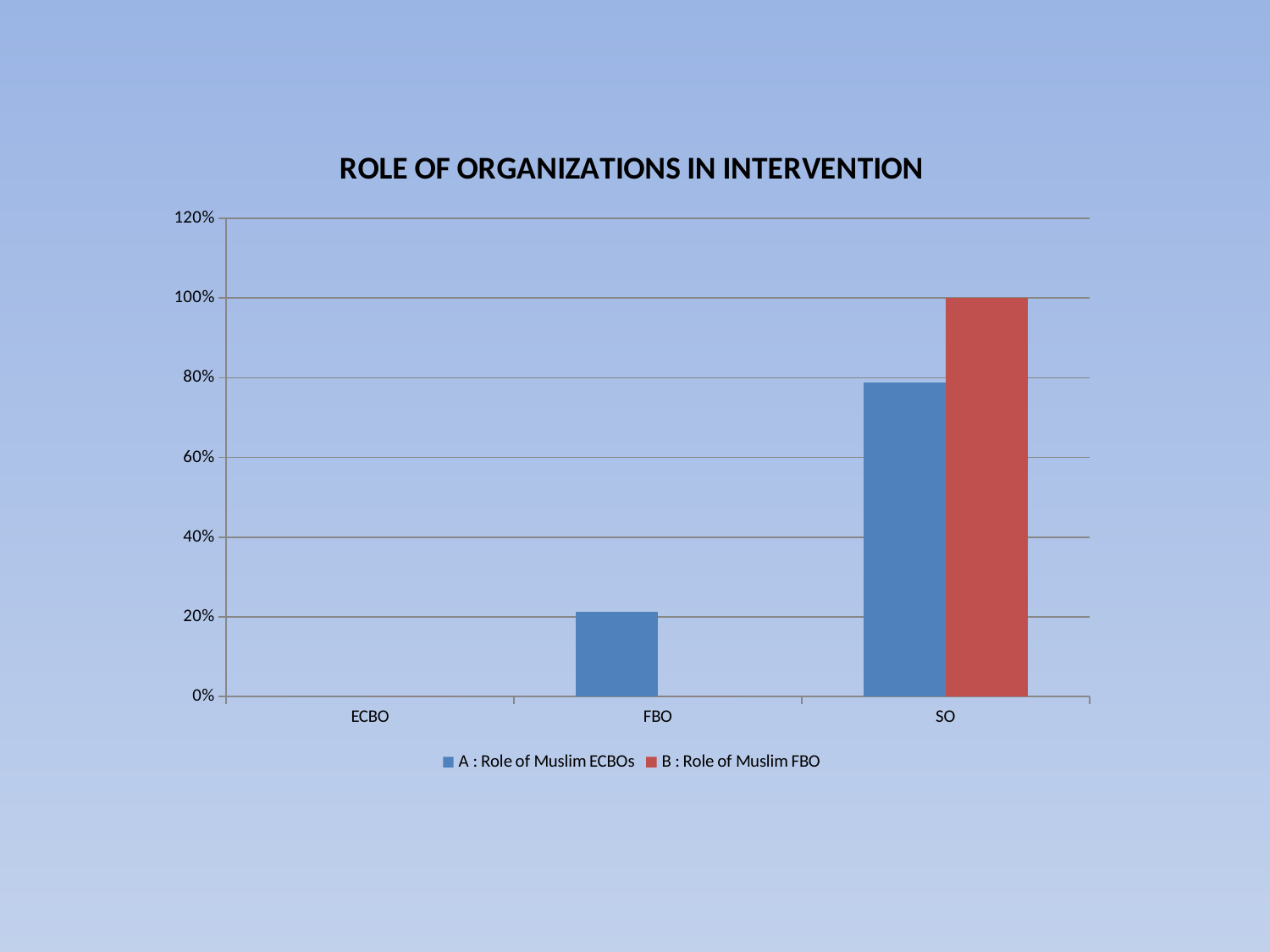
What kind of chart is shown on the slide? bar chart What is the value for SO in the series B : Role of Muslim FBO? 100% Which category has the highest value for the series A : Role of Muslim ECBOs? SO Is the value for SO in the series A : Role of Muslim ECBOs greater or less than 60%? greater How many categories are shown on the x axis? 3 Is the value for FBO in the series A : Role of Muslim ECBOs greater or less than 40%? less What colour represents the series B : Role of Muslim FBO in the legend? red Do the values for the series A : Role of Muslim ECBOs rise or fall from ECBO to SO along the x axis? rise How many series does the legend list? 2 For the category SO, which series has the larger value: A : Role of Muslim ECBOs or B : Role of Muslim FBO? B : Role of Muslim FBO What is the title of the chart? ROLE OF ORGANIZATIONS IN INTERVENTION Which category has the lowest value for the series A : Role of Muslim ECBOs? ECBO